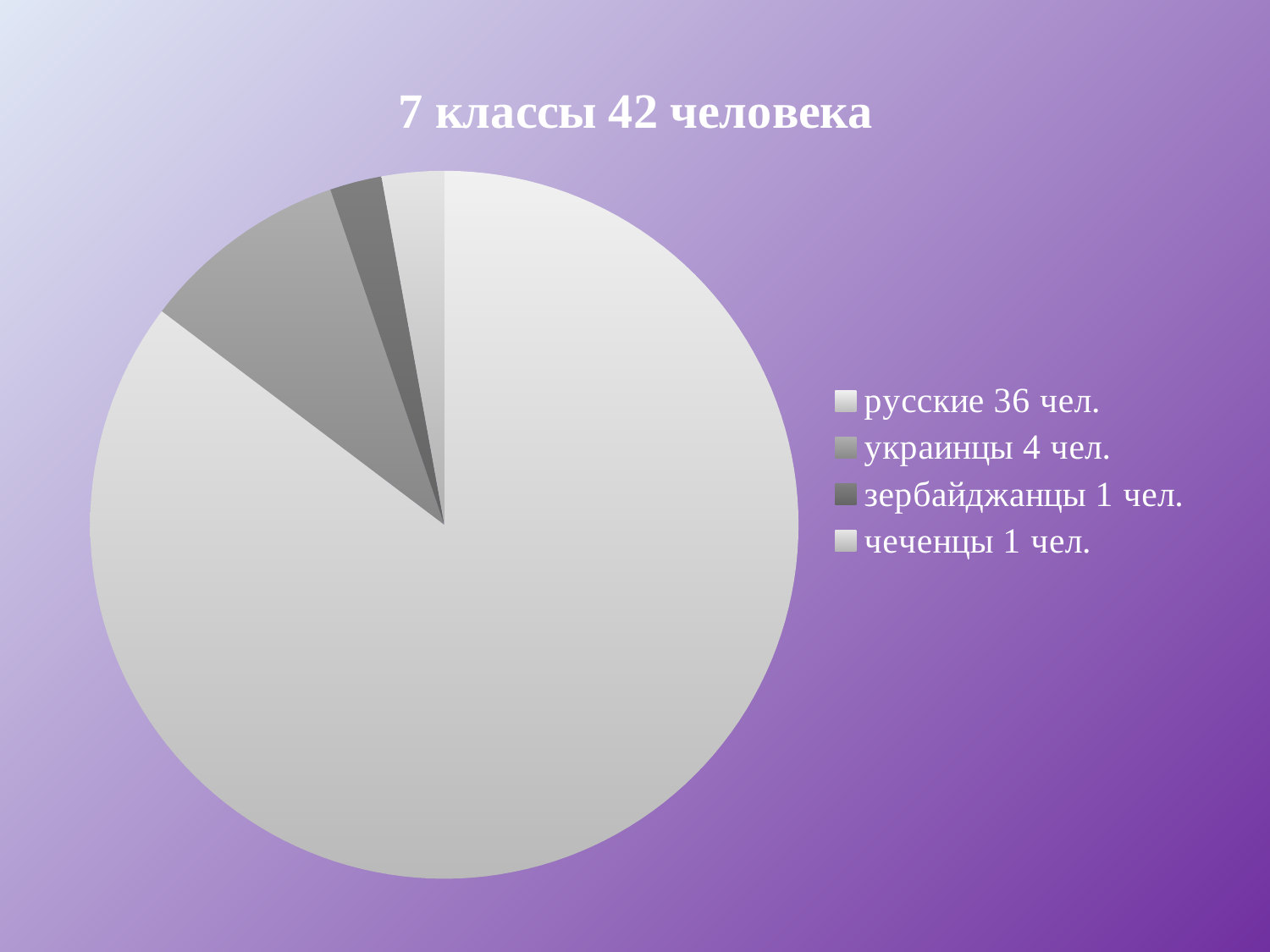
What kind of chart is shown on the slide? pie chart How many people are in the украинцы category? 4 чел. What is the title of the chart? 7 классы 42 человека How many categories does the pie chart have? 4 How many people are in the русские category? 36 чел. Which category has the largest slice of the pie? русские How many people are in the чеченцы category? 1 чел. Which is larger, украинцы or чеченцы? украинцы What is the difference between the number of русские and the number of украинцы? 32 Which two categories share the smallest value? зербайджанцы and чеченцы Which legend entry is listed third? зербайджанцы 1 чел. What is the total number of people across all categories? 42